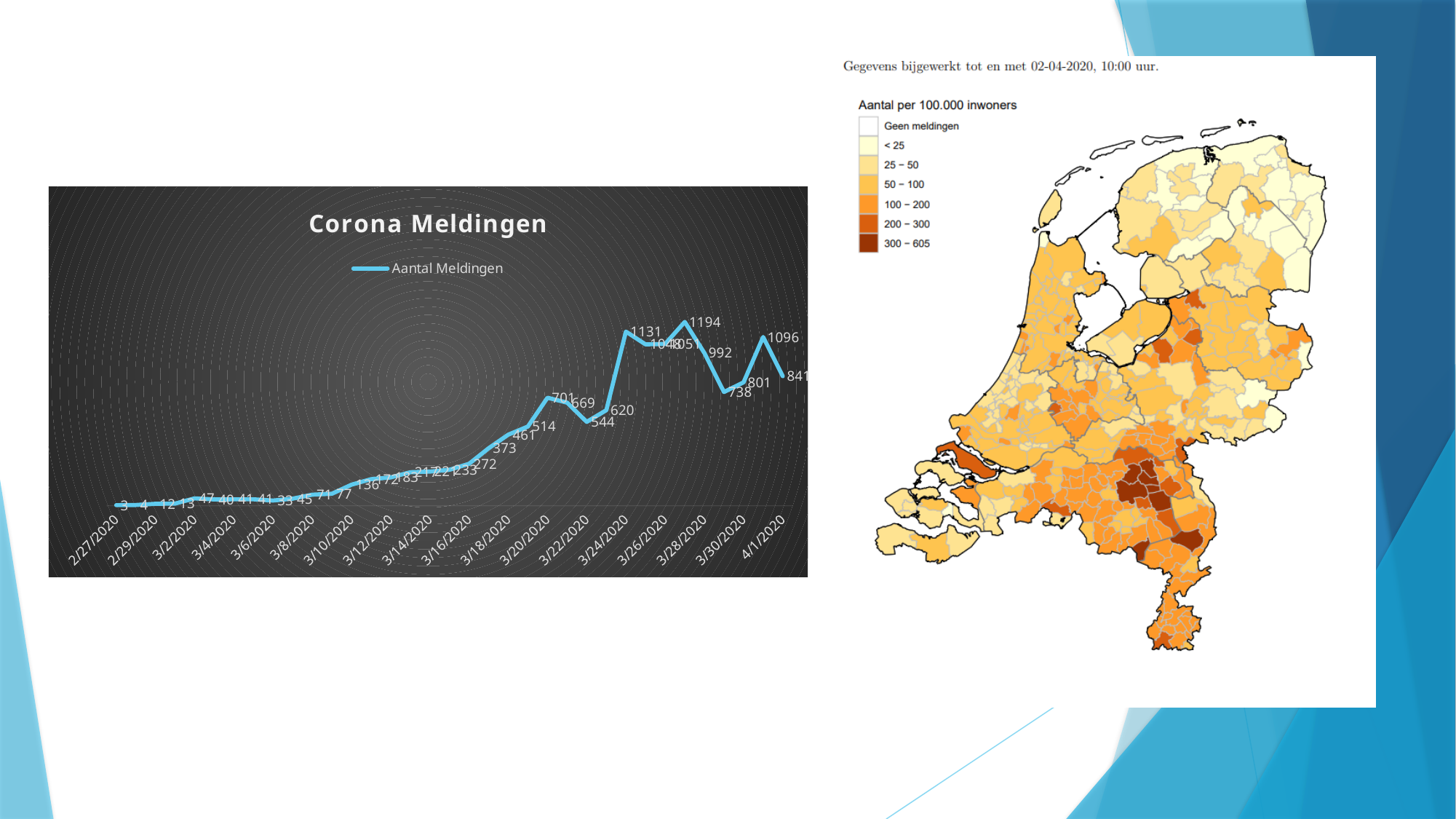
In the 'Corona Meldingen' chart, what is the value for 4/1/2020? 841 In the 'Corona Meldingen' chart, what is the value for 3/24/2020? 1131 In the 'Corona Meldingen' chart, what is the difference between the value for 3/24/2020 and the value for 4/1/2020? 290 In the 'Corona Meldingen' chart, what is the value for 3/16/2020? 272 In the 'Corona Meldingen' chart, what is the lowest value plotted? 3 What is the name of the series shown in the legend of the 'Corona Meldingen' chart? Aantal Meldingen In the 'Corona Meldingen' chart, what is the value for 3/20/2020? 701 In the 'Corona Meldingen' chart, do the values overall rise or fall from 2/27/2020 to 4/1/2020? rise How many series does the legend of the 'Corona Meldingen' chart list? 1 In the 'Corona Meldingen' chart, what is the highest value plotted? 1194 What kind of chart is the 'Corona Meldingen' chart? line chart In the 'Corona Meldingen' chart, which is larger: the value for 3/20/2020 or the value for 4/1/2020? 4/1/2020